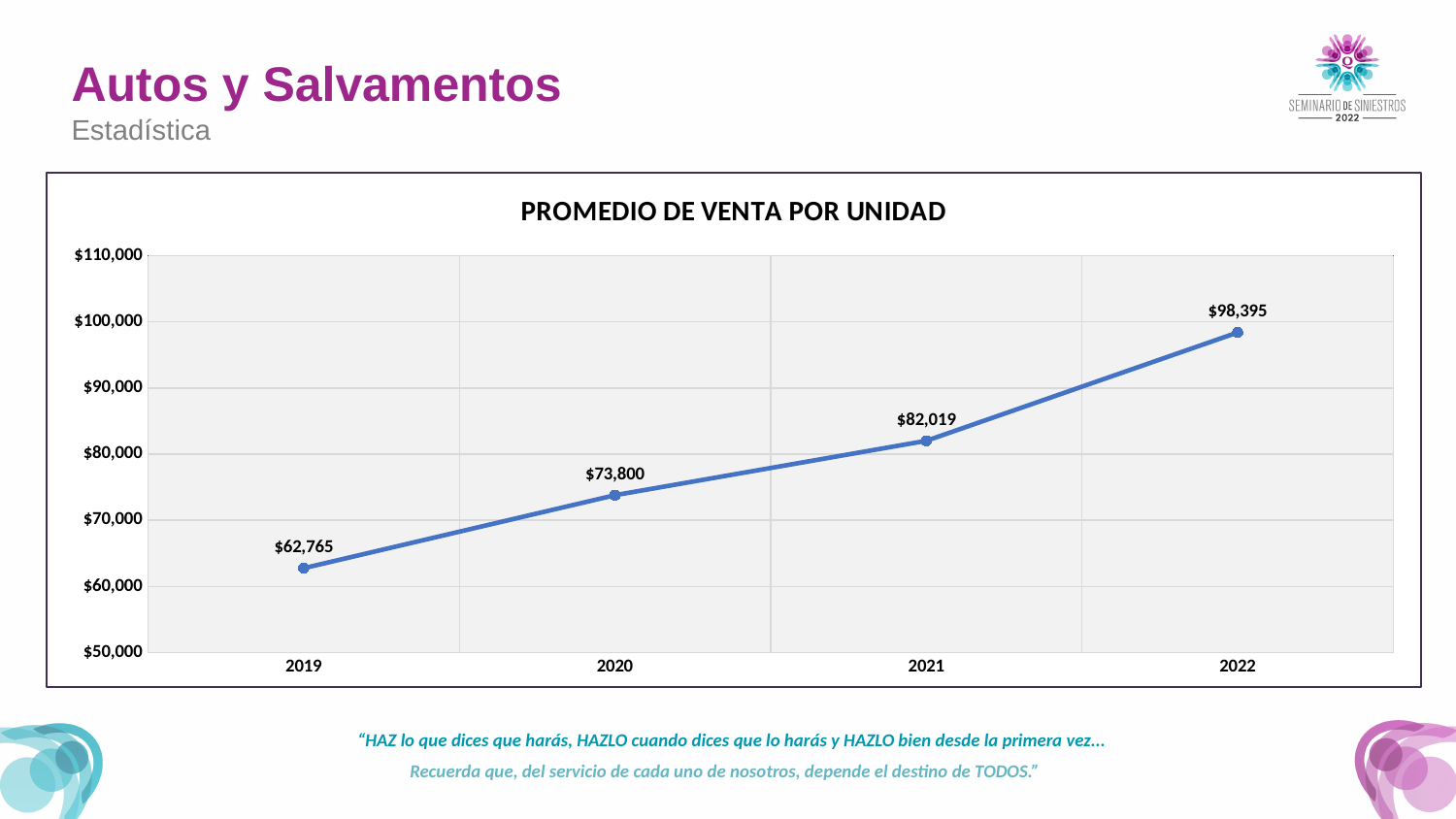
What is the difference between the 2022 value and the 2021 value? $16,376 What kind of chart is shown on the slide? line chart Which year has the highest average sale per unit? 2022 How many years are plotted on the chart? 4 Which year has the lowest average sale per unit? 2019 What is the difference between the 2020 value and the 2019 value? $11,035 What is the value plotted for 2021? $82,019 What is the average sale per unit shown for 2019? $62,765 Is the value for 2022 greater or less than $90,000? greater What is the value plotted for 2022? $98,395 Do the values rise or fall from 2019 to 2022? rise Which is larger, the value for 2020 or the value for 2021? 2021